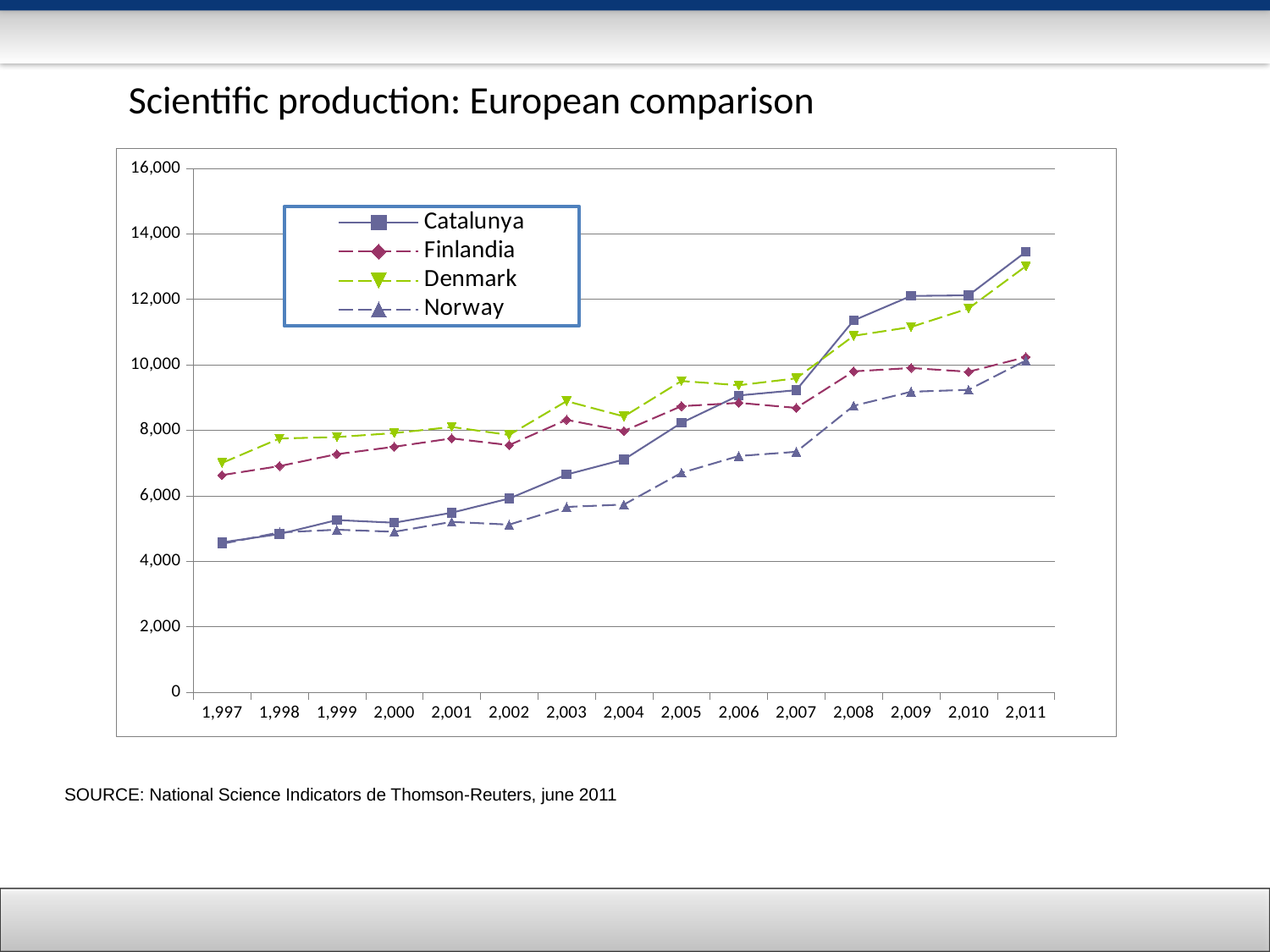
How many series does the legend list? 4 Which series has the lowest value in 2003? Norway Is the value for Norway in 2011 greater or less than 8,000? greater In 2001, which is larger: the value for Finlandia or the value for Norway? Finlandia Is the value for Catalunya in 1997 greater or less than 6,000? less Does the Catalunya series rise or fall from 1997 to 2011? rise What is the title of the slide? Scientific production: European comparison Is the value for Finlandia in 2008 greater or less than 8,000? greater Which series has the highest value in 1997? Denmark What kind of chart is shown on the slide? line chart How many years are shown on the x axis? 15